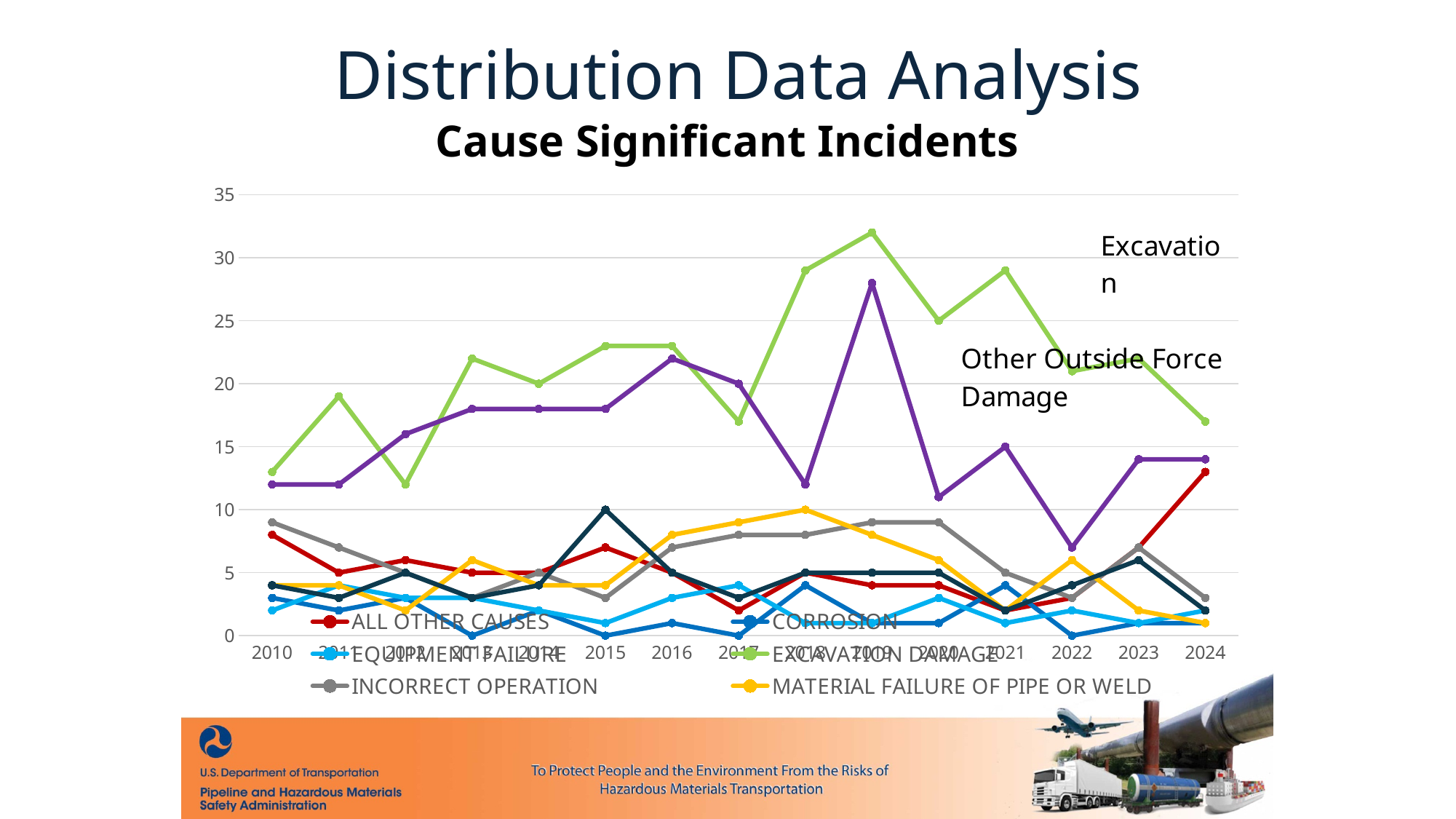
How many years are shown along the x axis of the chart? 15 What kind of chart is shown on the slide? Line chart In which year does the EXCAVATION DAMAGE line reach its highest value? 2019 Is the value for EXCAVATION DAMAGE in 2024 greater or less than 20? less How many series does the chart legend list? 6 In 2018, which is higher: EXCAVATION DAMAGE or Other Outside Force Damage? EXCAVATION DAMAGE What is the highest value shown on the chart's y axis? 35 Is the value for EXCAVATION DAMAGE in 2019 greater or less than 30? greater What is the subtitle of the chart on the slide? Cause Significant Incidents Is the value for Other Outside Force Damage in 2019 greater or less than 25? greater In which year does the EXCAVATION DAMAGE line reach its lowest value? 2012 Does the EXCAVATION DAMAGE line rise or fall from 2021 to 2024? Fall